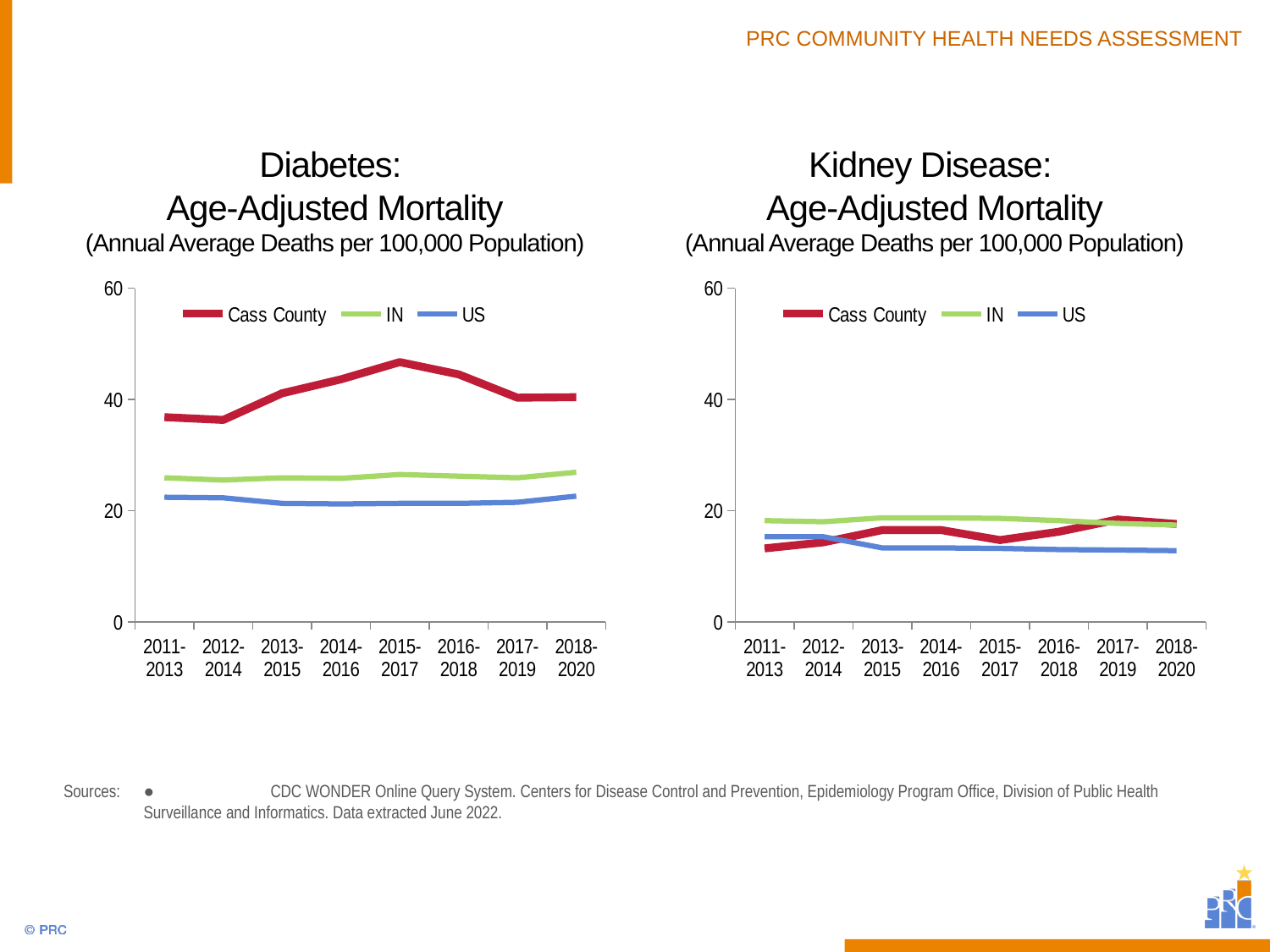
What kind of chart is the Diabetes: Age-Adjusted Mortality chart? Line chart In the Kidney Disease: Age-Adjusted Mortality chart, is the Cass County value for 2011-2013 greater or less than 20? less In the Diabetes: Age-Adjusted Mortality chart, which is larger in 2015-2017, Cass County or US? Cass County In the Kidney Disease: Age-Adjusted Mortality chart, does the US line rise or fall from 2011-2013 to 2018-2020? fall In the Diabetes: Age-Adjusted Mortality chart, is the Cass County value for 2011-2013 greater or less than 40? less What colour is the Cass County line in the Kidney Disease: Age-Adjusted Mortality chart? Red In the Diabetes: Age-Adjusted Mortality chart, in which period is the Cass County value highest? 2015-2017 In the Kidney Disease: Age-Adjusted Mortality chart, which is larger in 2011-2013, IN or Cass County? IN In the Diabetes: Age-Adjusted Mortality chart, is the Cass County value for 2015-2017 greater or less than 40? greater How many time periods are shown on the x axis of the Diabetes: Age-Adjusted Mortality chart? 8 In the Diabetes: Age-Adjusted Mortality chart, does the Cass County line rise or fall from 2012-2014 to 2015-2017? rise How many series does the legend of the Kidney Disease: Age-Adjusted Mortality chart list? 3